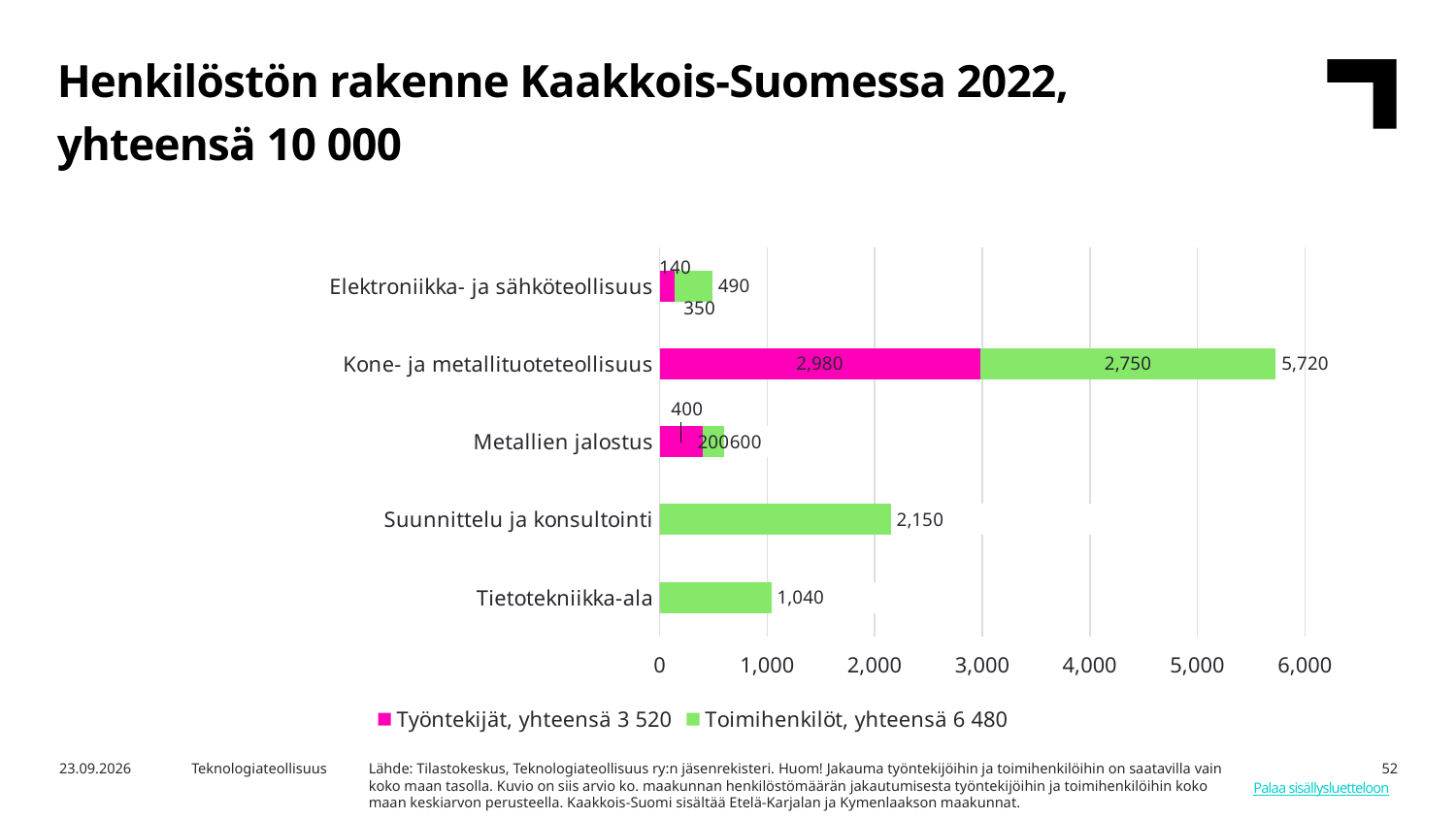
Which category has the highest total? Kone- ja metallituoteteollisuus How many series does the legend list? 2 What is the Työntekijät value for Kone- ja metallituoteteollisuus? 2,980 What is the Työntekijät value for Metallien jalostus? 400 How many categories are shown on the chart? 5 What is the Toimihenkilöt value for Kone- ja metallituoteteollisuus? 2,750 What is the total for the Kone- ja metallituoteteollisuus bar? 5,720 What is the difference between the Työntekijät and Toimihenkilöt values for Elektroniikka- ja sähköteollisuus? 210 Which category has the lowest total? Elektroniikka- ja sähköteollisuus What type of chart is shown on the slide? bar chart What is the value for Tietotekniikka-ala? 1,040 What is the Toimihenkilöt value for Suunnittelu ja konsultointi? 2,150